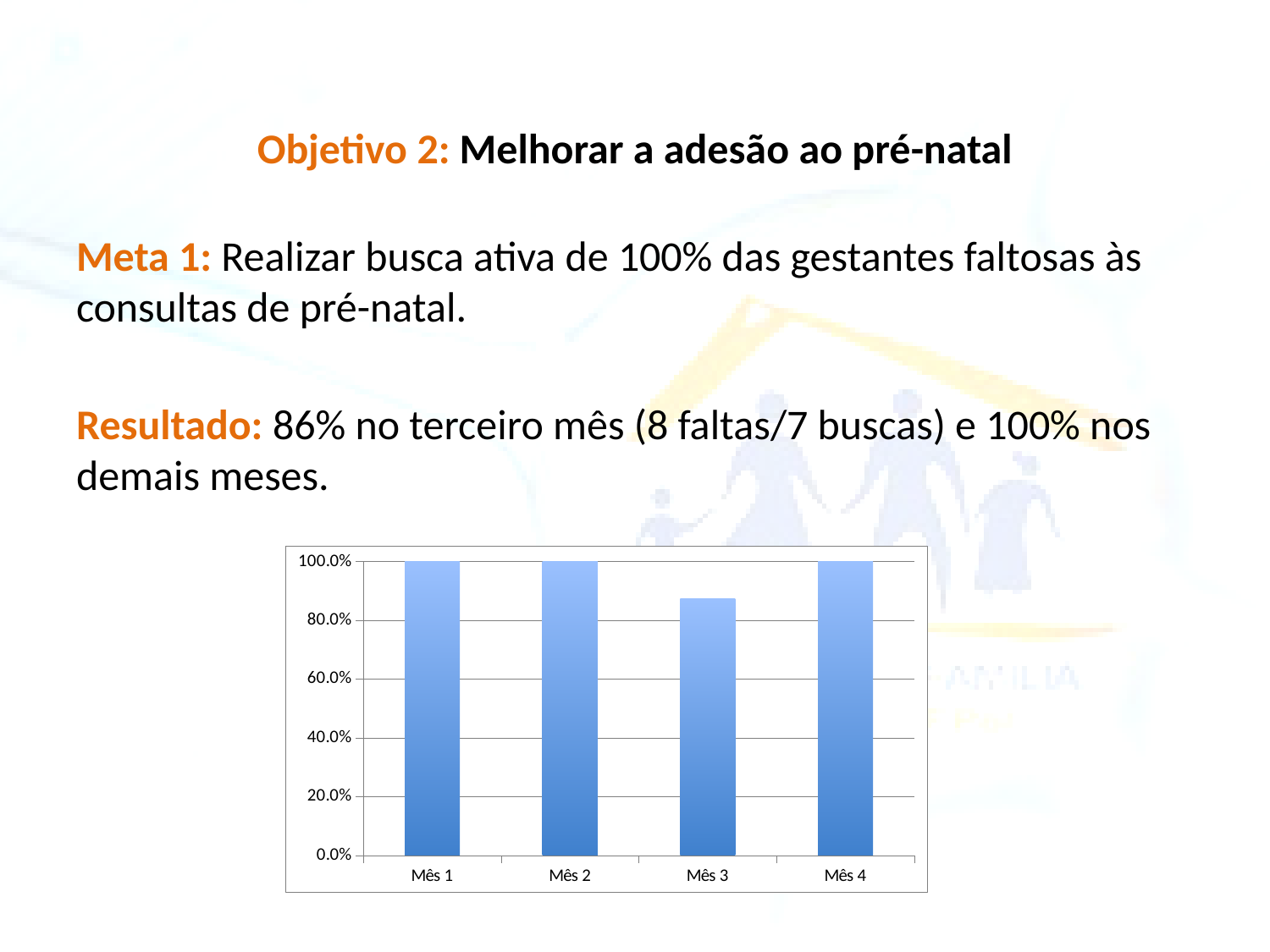
What is the highest tick value shown on the y axis of the chart? 100.0% Does the value rise or fall from Mês 2 to Mês 3? fall What is the value for Mês 1 in the chart? 100.0% Which is larger, the value for Mês 2 or the value for Mês 3? Mês 2 What kind of chart is shown on the slide? bar chart How many categories (months) are shown on the x axis of the chart? 4 What is the label of the first category on the x axis of the chart? Mês 1 What is the value for Mês 4 in the chart? 100.0% What is the value for Mês 2 in the chart? 100.0% Which month has the lowest value in the chart? Mês 3 Is the value for Mês 3 greater or less than 80.0%? greater Is the value for Mês 3 greater or less than 100.0%? less